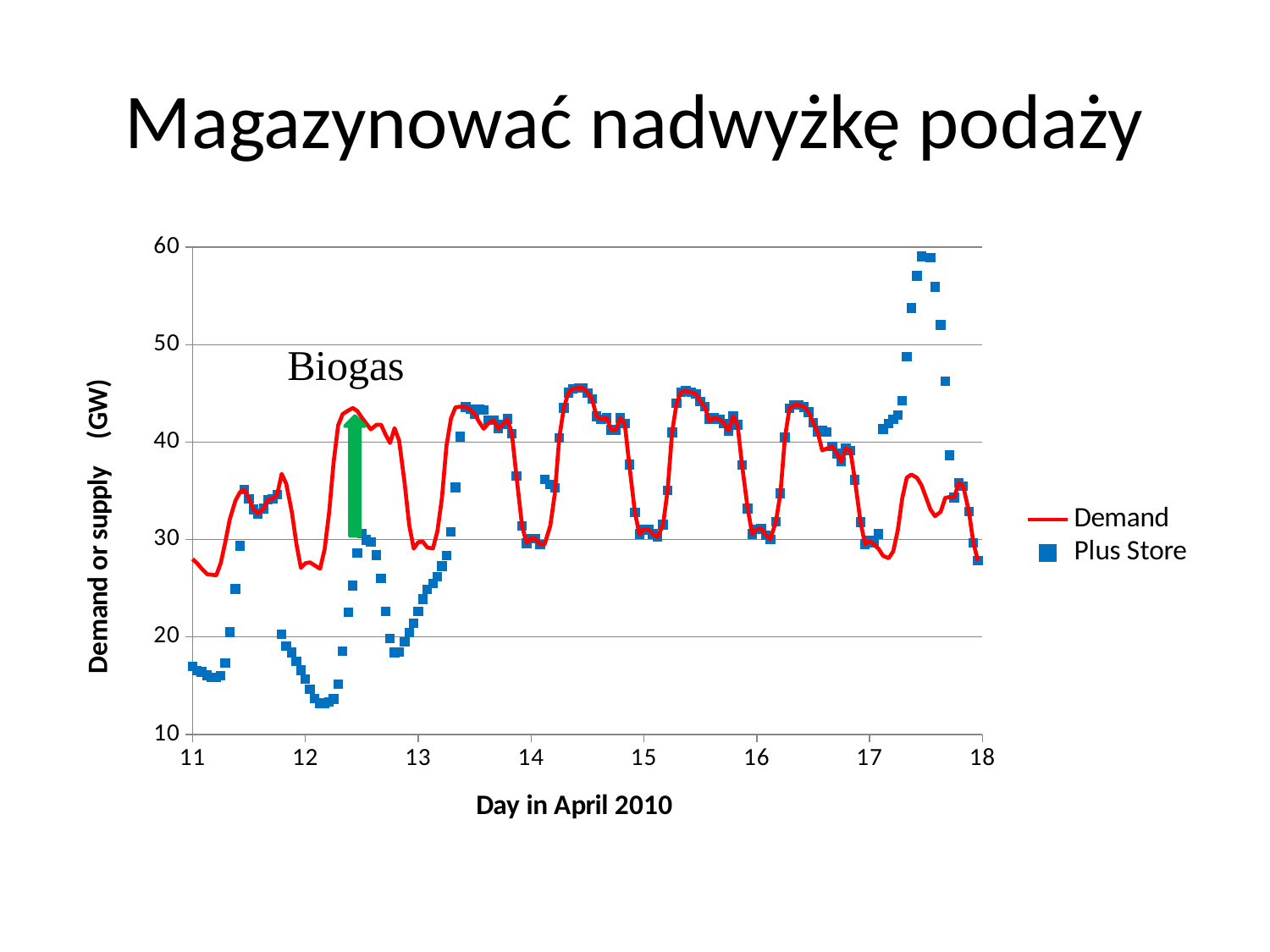
Is the Demand value at day 11 greater or less than 30? less What is the title of the vertical axis of the chart? Demand or supply (GW) What is the highest value shown on the vertical axis? 60 Is the highest value of the Plus Store series greater or less than 50? greater Around day 17.5, which series has the larger value, Demand or Plus Store? Plus Store Which series is drawn as a red line? Demand Is the lowest value of the Plus Store series, near day 12, greater or less than 20? less How many series does the chart legend list? 2